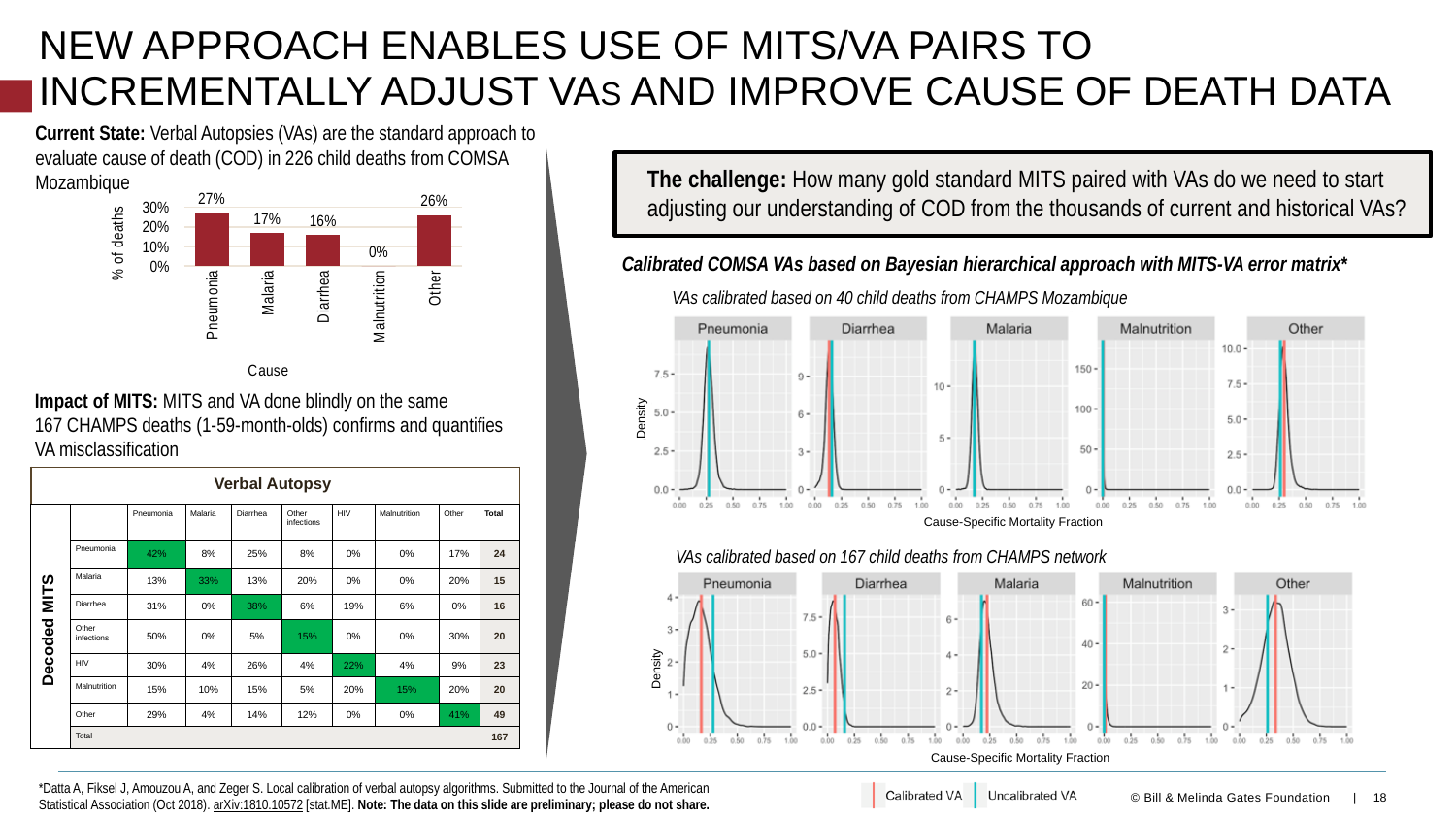
What is the x-axis title of the bar chart on the left showing % of deaths? Cause In the bar chart on the left showing % of deaths by cause, what is the value for Malnutrition? 0% In the bar chart on the left showing % of deaths by cause, which is larger, the value for Other or the value for Diarrhea? Other In the bar chart on the left showing % of deaths by cause, what is the value for Malaria? 17% In the bar chart on the left showing % of deaths by cause, what is the value for Other? 26% In the bar chart on the left showing % of deaths by cause, what is the value for Diarrhea? 16% In the bar chart on the left showing % of deaths by cause, what is the value for Pneumonia? 27% In the bar chart on the left showing % of deaths by cause, what is the difference between the values for Pneumonia and Malaria? 10% How many causes are shown on the x axis of the bar chart on the left showing % of deaths? 5 In the bar chart on the left showing % of deaths by cause, which cause has the highest value? Pneumonia In the bar chart on the left showing % of deaths by cause, which cause has the lowest value? Malnutrition What kind of chart is the % of deaths by cause chart on the left of the slide? Bar chart